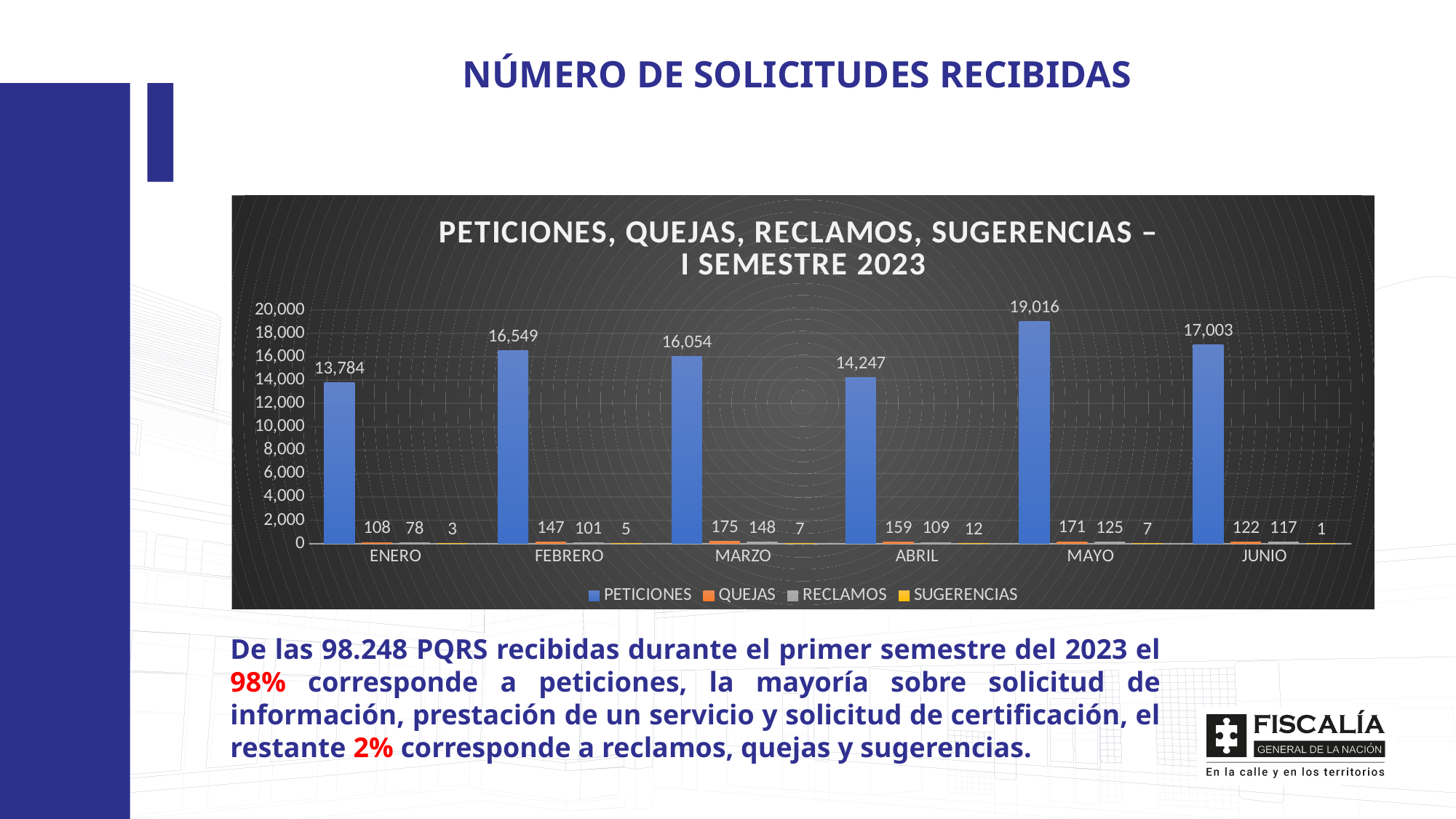
What is the value of RECLAMOS for FEBRERO? 101 What is the difference between the PETICIONES values for MAYO and ENERO? 5,232 What is the value of PETICIONES for MAYO? 19,016 Which is larger, the PETICIONES value for FEBRERO or for MARZO? FEBRERO What is the value of QUEJAS for MARZO? 175 Which month has the highest value for PETICIONES? MAYO How many months are shown on the x axis of the chart? 6 How many series does the chart legend list? 4 What kind of chart is shown on the slide? Bar chart Which month has the lowest value for PETICIONES? ENERO What is the value of SUGERENCIAS for ABRIL? 12 What is the title of the chart? PETICIONES, QUEJAS, RECLAMOS, SUGERENCIAS – I SEMESTRE 2023